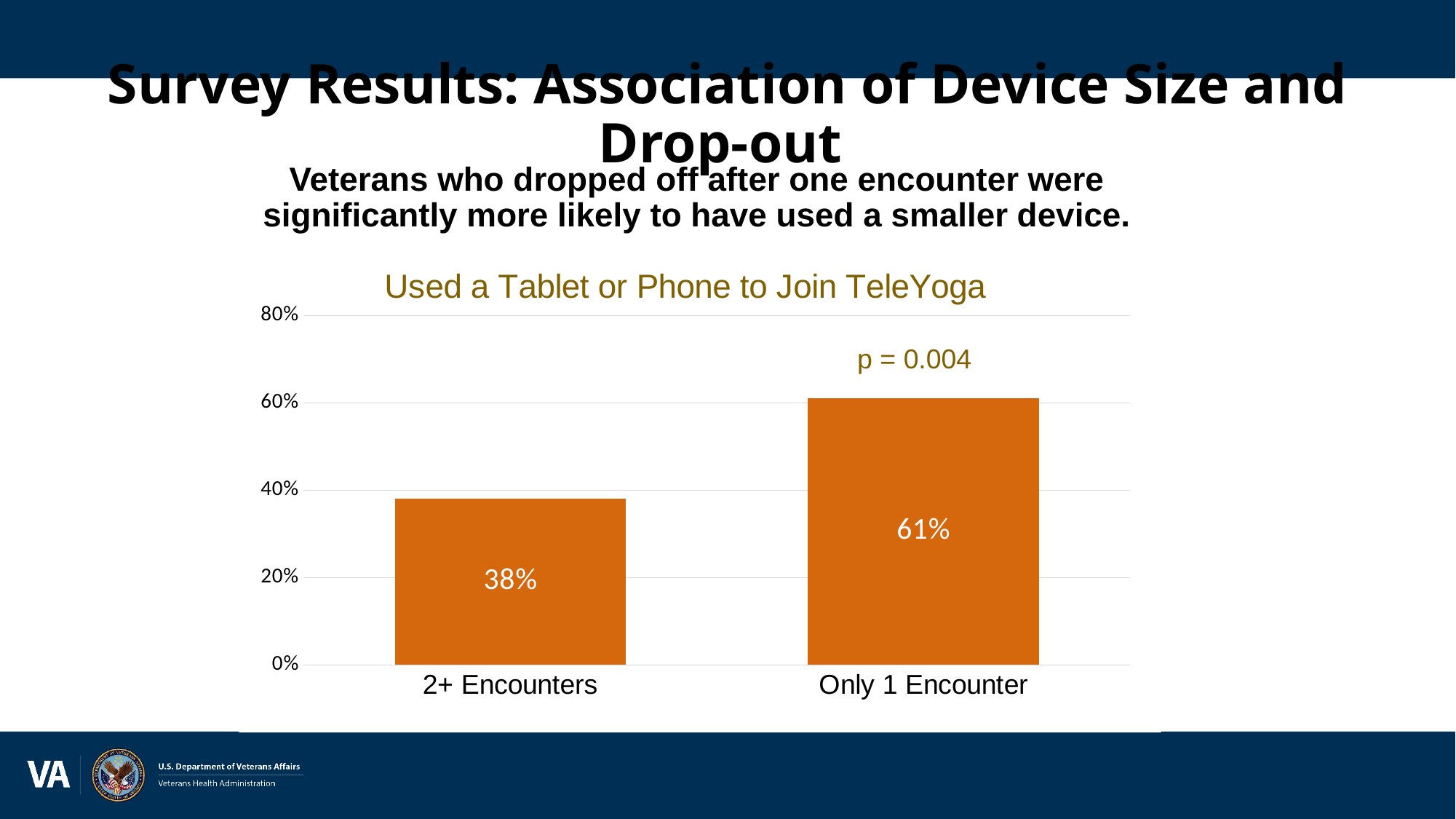
What is the difference in percentage points between Only 1 Encounter and 2+ Encounters? 23% How many categories are shown on the chart? 2 Is the value for 2+ Encounters greater or less than 40%? less Is the value for 2+ Encounters larger or smaller than the value for Only 1 Encounter? smaller Which category has the higher percentage of tablet or phone use? Only 1 Encounter What is the title of the chart? Used a Tablet or Phone to Join TeleYoga Is the value for Only 1 Encounter greater or less than 60%? greater What percentage of veterans with Only 1 Encounter used a tablet or phone to join TeleYoga? 61% What p-value is printed on the chart? p = 0.004 Which category has the lower percentage of tablet or phone use? 2+ Encounters What percentage of veterans with 2+ Encounters used a tablet or phone to join TeleYoga? 38% What kind of chart is shown on the slide? bar chart